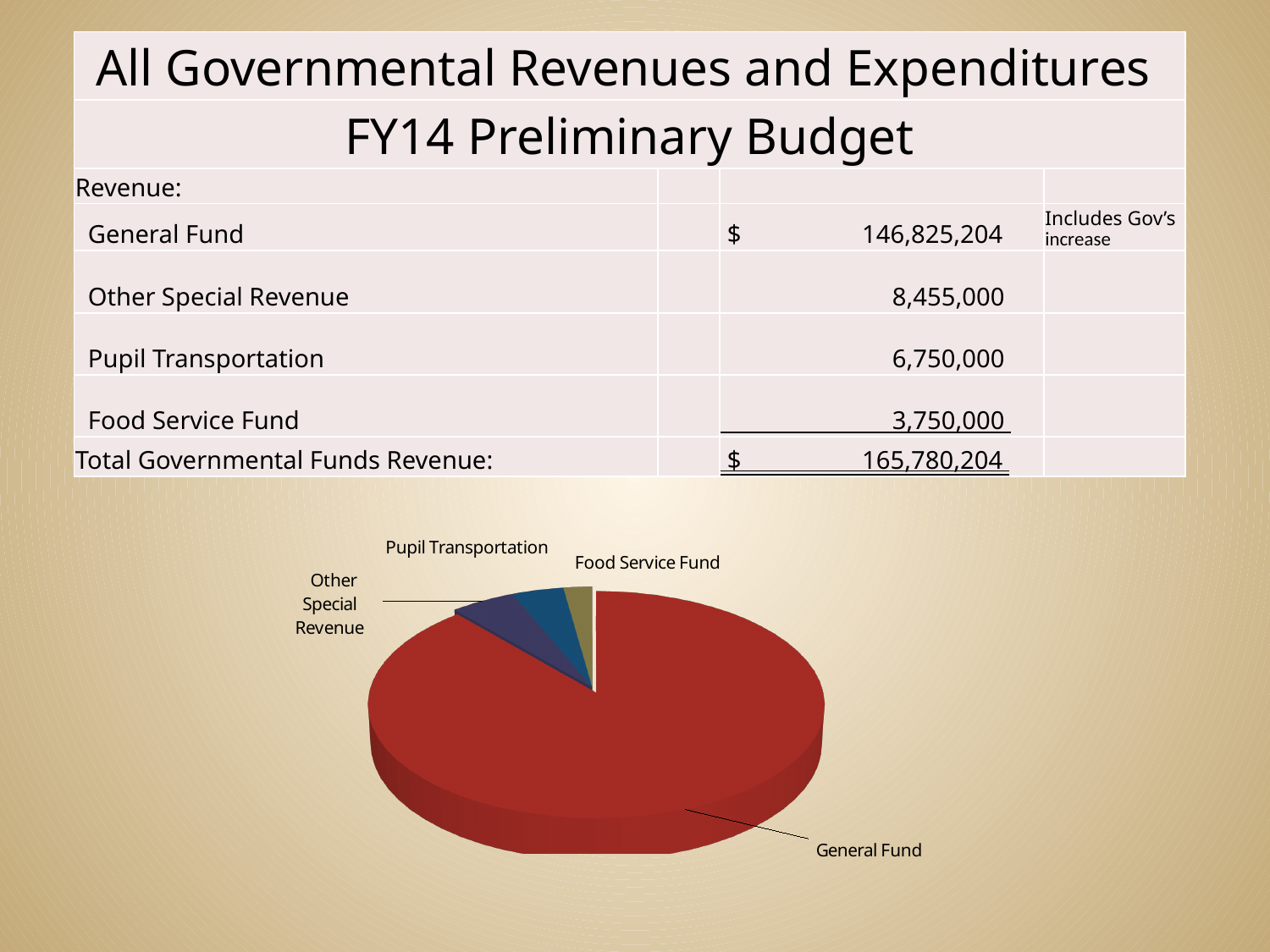
What is the revenue value for the Pupil Transportation slice? 6,750,000 What is the total of all the revenue categories shown in the pie chart? $165,780,204 Which slice of the pie chart is the largest? General Fund What colour is the General Fund slice of the pie chart? red Which slice of the pie chart is the smallest? Food Service Fund What is the difference between the Pupil Transportation value and the Food Service Fund value? 3,000,000 Which is larger, the Pupil Transportation slice or the Food Service Fund slice? Pupil Transportation What is the revenue value for the Other Special Revenue slice? 8,455,000 What kind of chart is shown on the slide? pie chart What is the revenue value for the Food Service Fund slice? 3,750,000 How many slices does the pie chart have? 4 What is the revenue value for the General Fund slice? $146,825,204